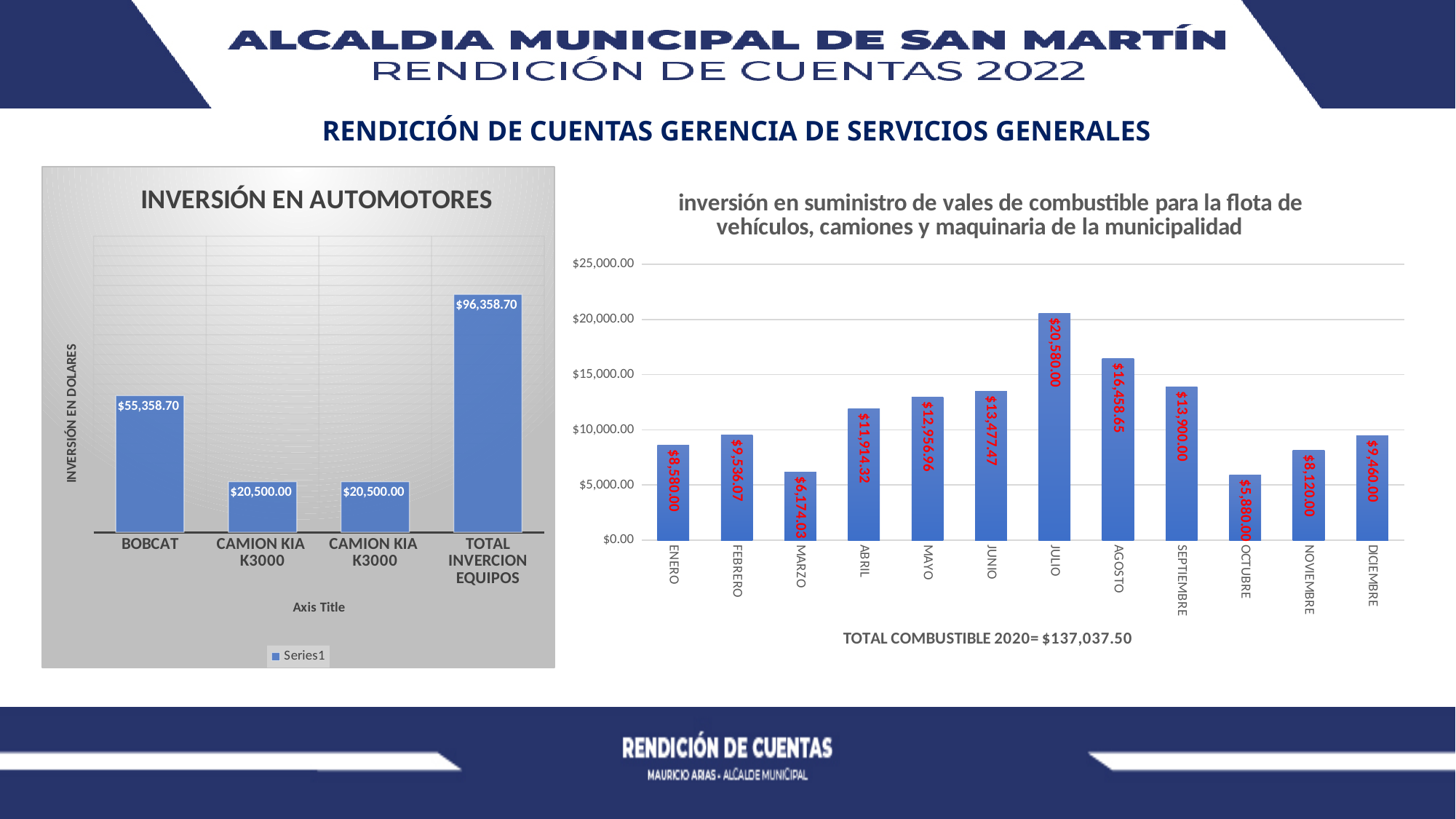
In the fuel voucher chart on the right, what is the difference between the values for JULIO and AGOSTO? $4,121.35 In the chart titled INVERSIÓN EN AUTOMOTORES, what is the value for TOTAL INVERCION EQUIPOS? $96,358.70 In the chart titled INVERSIÓN EN AUTOMOTORES, how many bars are plotted? 4 In the chart titled INVERSIÓN EN AUTOMOTORES, what is the value for each CAMION KIA K3000 bar? $20,500.00 In the fuel voucher chart on the right, which month has the lowest value? OCTUBRE In the fuel voucher chart on the right, how many months are plotted? 12 In the fuel voucher chart on the right, which month has the highest value? JULIO In the chart titled INVERSIÓN EN AUTOMOTORES, what is the value for BOBCAT? $55,358.70 In the chart titled INVERSIÓN EN AUTOMOTORES, what is the difference between the BOBCAT value and one CAMION KIA K3000 value? $34,858.70 In the fuel voucher chart on the right, what is the value for JULIO? $20,580.00 In the chart titled INVERSIÓN EN AUTOMOTORES, what is the y-axis title? INVERSIÓN EN DOLARES In the fuel voucher chart on the right, which is larger, the value for ABRIL or the value for MAYO? MAYO